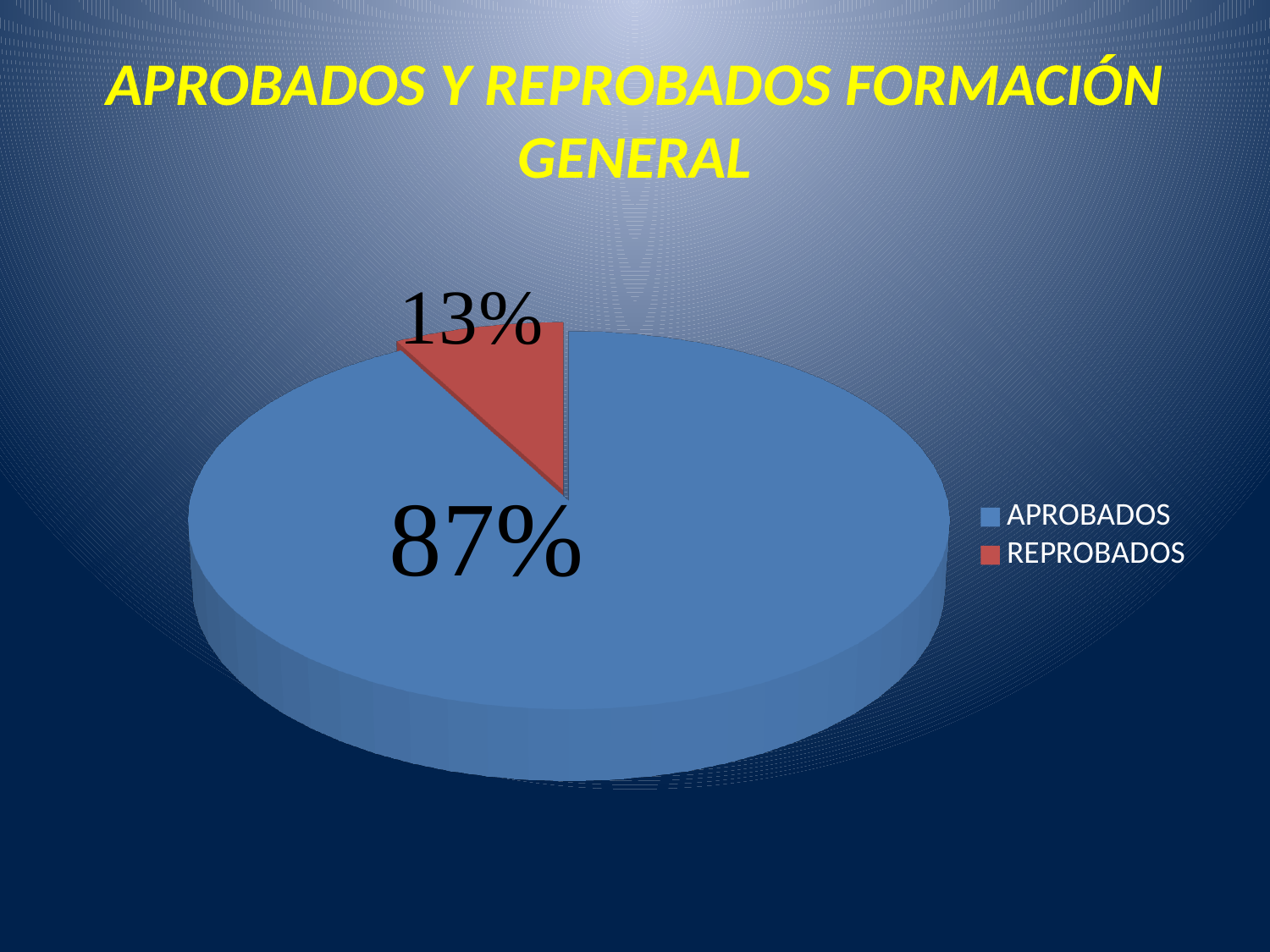
How many slices does the pie chart have? 2 What is the title of the chart? APROBADOS Y REPROBADOS FORMACIÓN GENERAL Which category has the smallest share of the pie? REPROBADOS What is the difference in percentage points between APROBADOS and REPROBADOS? 74 What colour is the REPROBADOS slice? Red What percentage of the pie is APROBADOS? 87% What percentage of the pie is REPROBADOS? 13% What kind of chart is shown on the slide? Pie chart Which is larger, the share for APROBADOS or the share for REPROBADOS? APROBADOS Which category has the largest share of the pie? APROBADOS How many entries does the legend list? 2